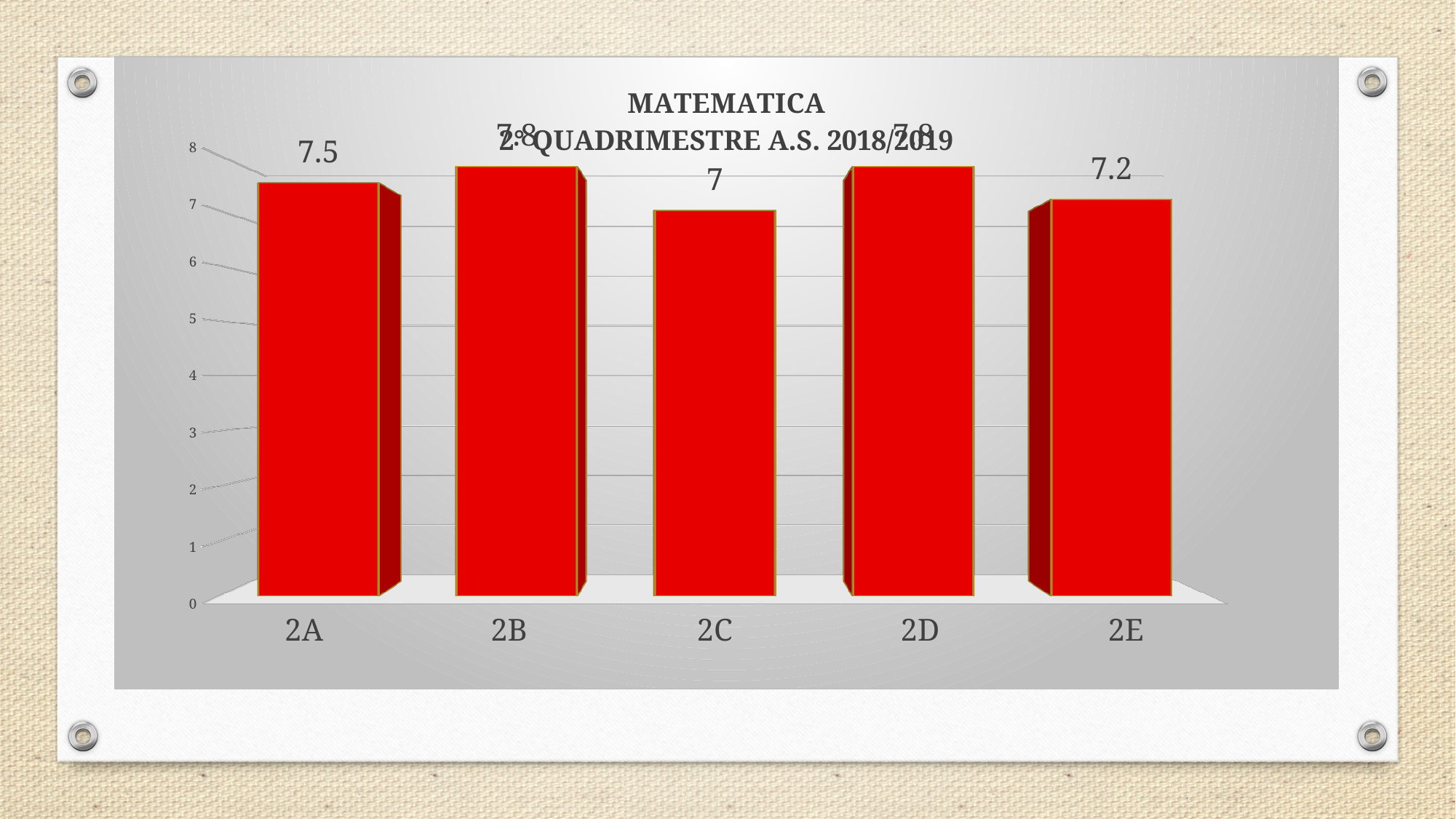
What is the value for 2E? 7.2 Which class has the lowest value? 2C What is the value for 2A? 7.5 Which is larger, the value for 2E or the value for 2A? 2A Which is larger, the value for 2A or the value for 2C? 2A What colour are the bars in the chart? red What is the value for 2C? 7 What is the difference between the values for 2A and 2E? 0.3 Is the value for 2B greater or less than 7? greater What kind of chart is shown on the slide? bar chart How many classes are shown on the x axis? 5 What is the difference between the values for 2A and 2C? 0.5